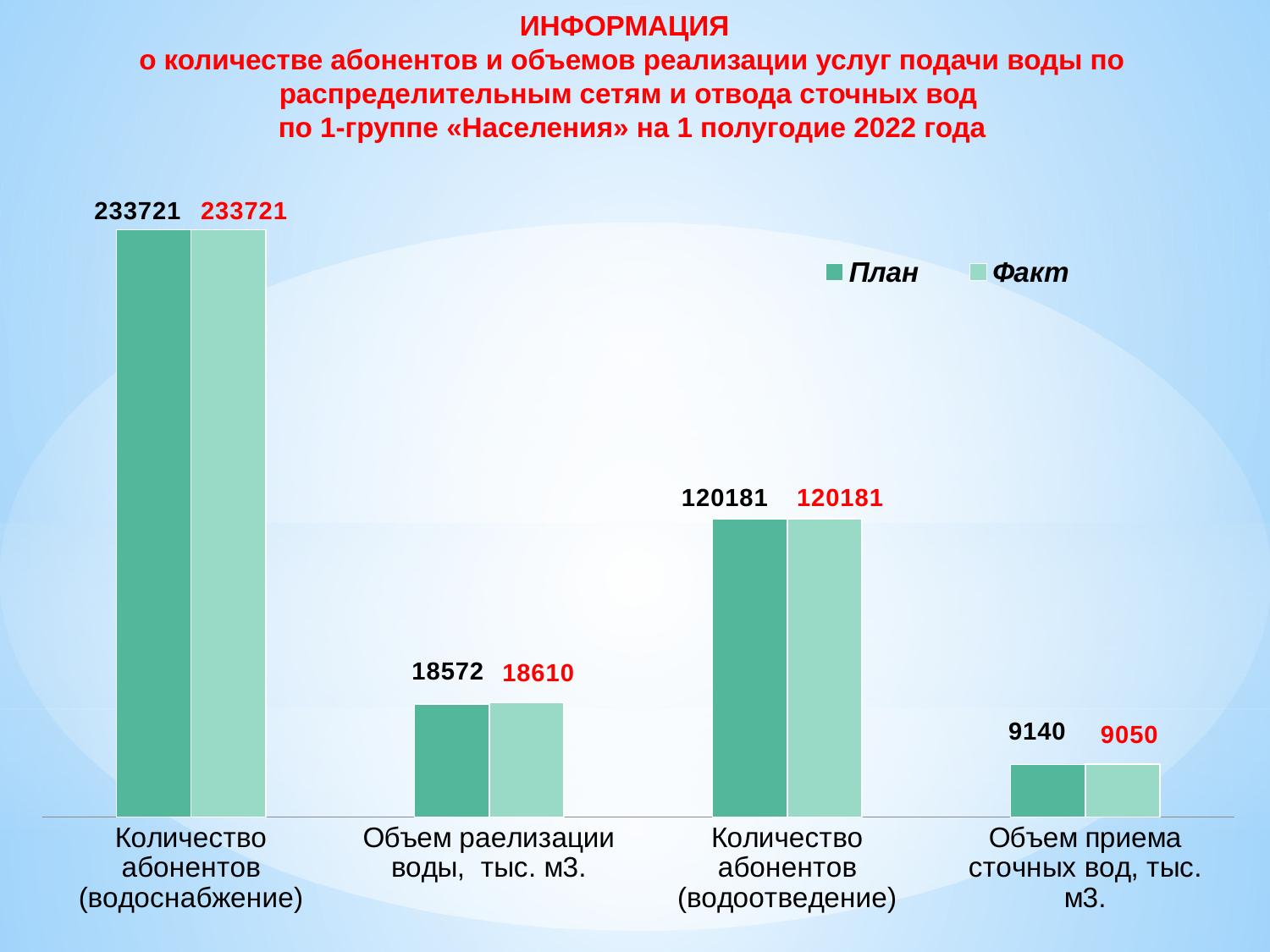
What is the Факт value for Объем раелизации воды, тыс. м3.? 18610 Which is larger for Количество абонентов (водоснабжение): the План value or the Количество абонентов (водоотведение) План value? Количество абонентов (водоснабжение) What is the План value for Количество абонентов (водоснабжение)? 233721 How many categories are shown on the x axis? 4 Which category has the lowest Факт value? Объем приема сточных вод, тыс. м3. How many series does the legend list? 2 What is the Факт value for Количество абонентов (водоотведение)? 120181 What kind of chart is shown on the slide? Bar chart What is the План value for Объем приема сточных вод, тыс. м3.? 9140 Which category has the highest План value? Количество абонентов (водоснабжение) What is the difference between the План and Факт values for Объем приема сточных вод, тыс. м3.? 90 What is the difference between the Факт and План values for Объем раелизации воды, тыс. м3.? 38